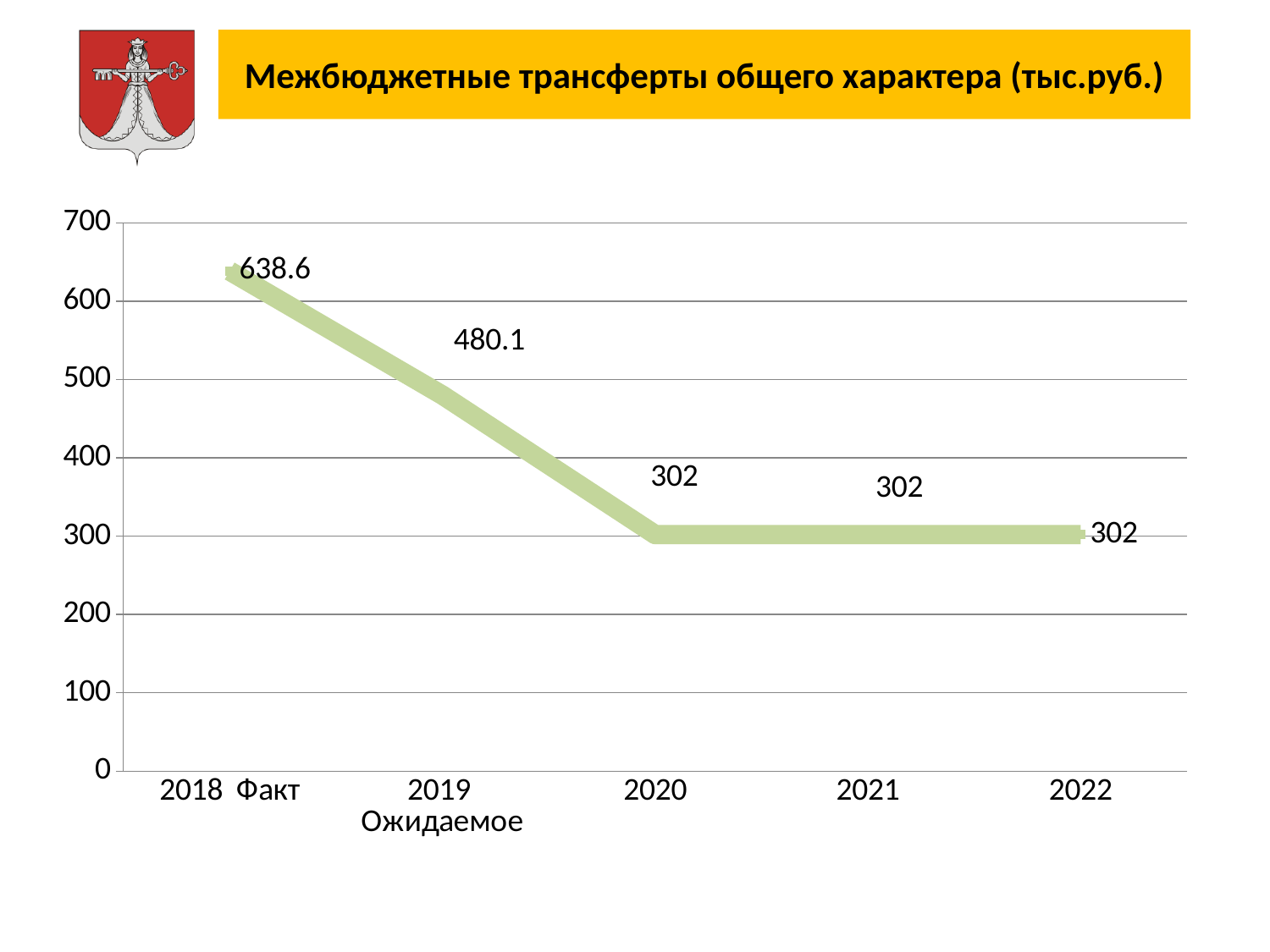
What is the difference between the values for 2018 Факт and 2019 Ожидаемое? 158.5 Which is larger, the value for 2018 Факт or the value for 2021? 2018 Факт Do the values rise or fall from 2018 to 2020? fall What is the value for 2022? 302 What kind of chart is shown on the slide? line chart Which year has the highest value? 2018 Факт How many data points are plotted on the chart? 5 What is the value for 2019 Ожидаемое? 480.1 What is the value for 2020? 302 What is the value for 2018 Факт? 638.6 Is the value for 2021 greater or less than 400? less What is the difference between the values for 2019 Ожидаемое and 2020? 178.1